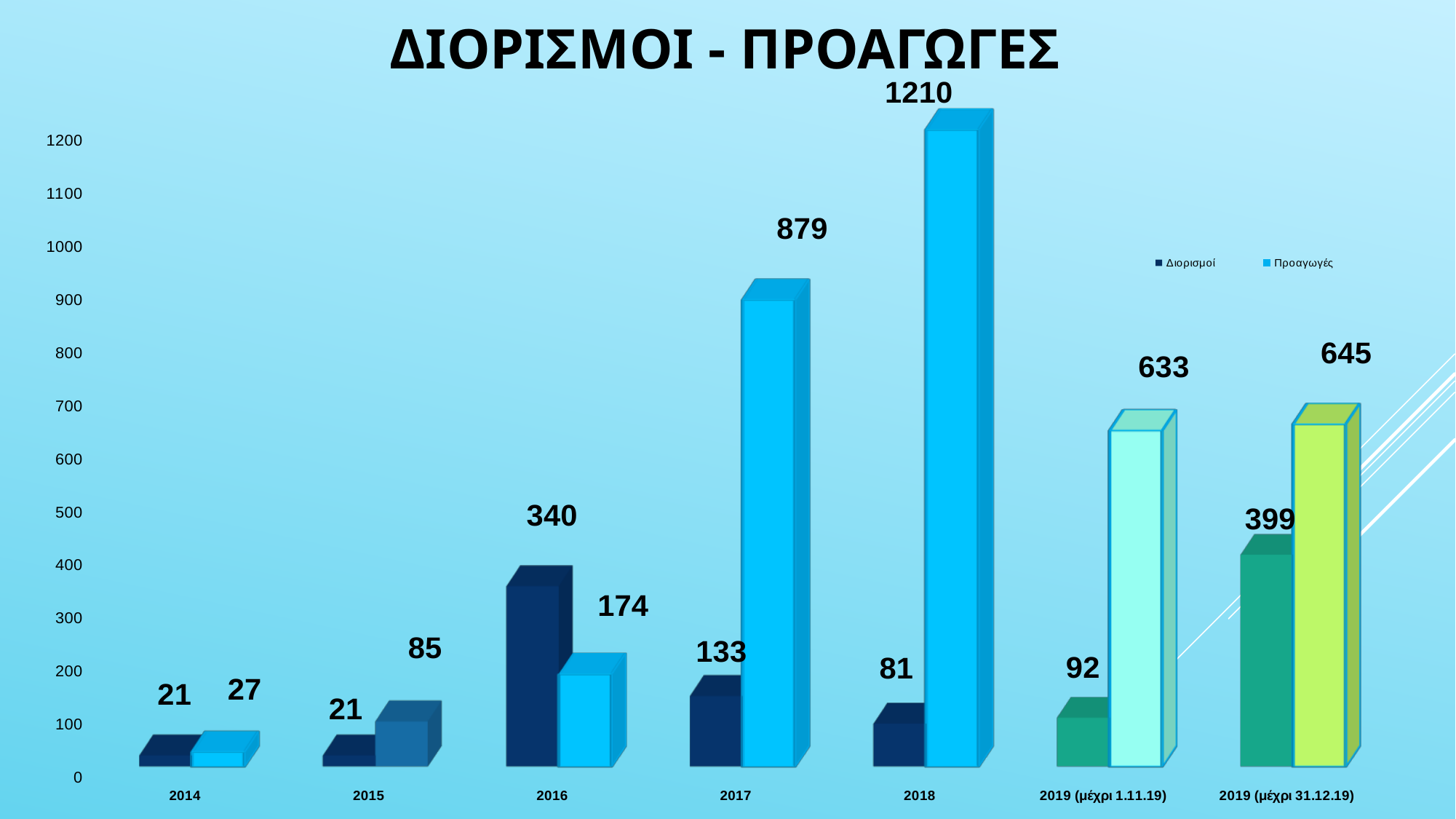
How many series does the legend list? 2 What is the title of the chart? ΔΙΟΡΙΣΜΟΙ - ΠΡΟΑΓΩΓΕΣ What is the value of Διορισμοί for 2016? 340 What kind of chart is shown on the slide? Bar chart What is the difference between Προαγωγές and Διορισμοί in 2017? 746 How many categories are shown on the x axis? 7 Which year has the highest value for Προαγωγές? 2018 Which category has the highest value for Διορισμοί? 2019 (μέχρι 31.12.19) What is the value of Προαγωγές for 2019 (μέχρι 31.12.19)? 645 What is the value of Προαγωγές for 2018? 1210 Which year has the lowest value for Προαγωγές? 2014 Which is larger in 2016: Διορισμοί or Προαγωγές? Διορισμοί